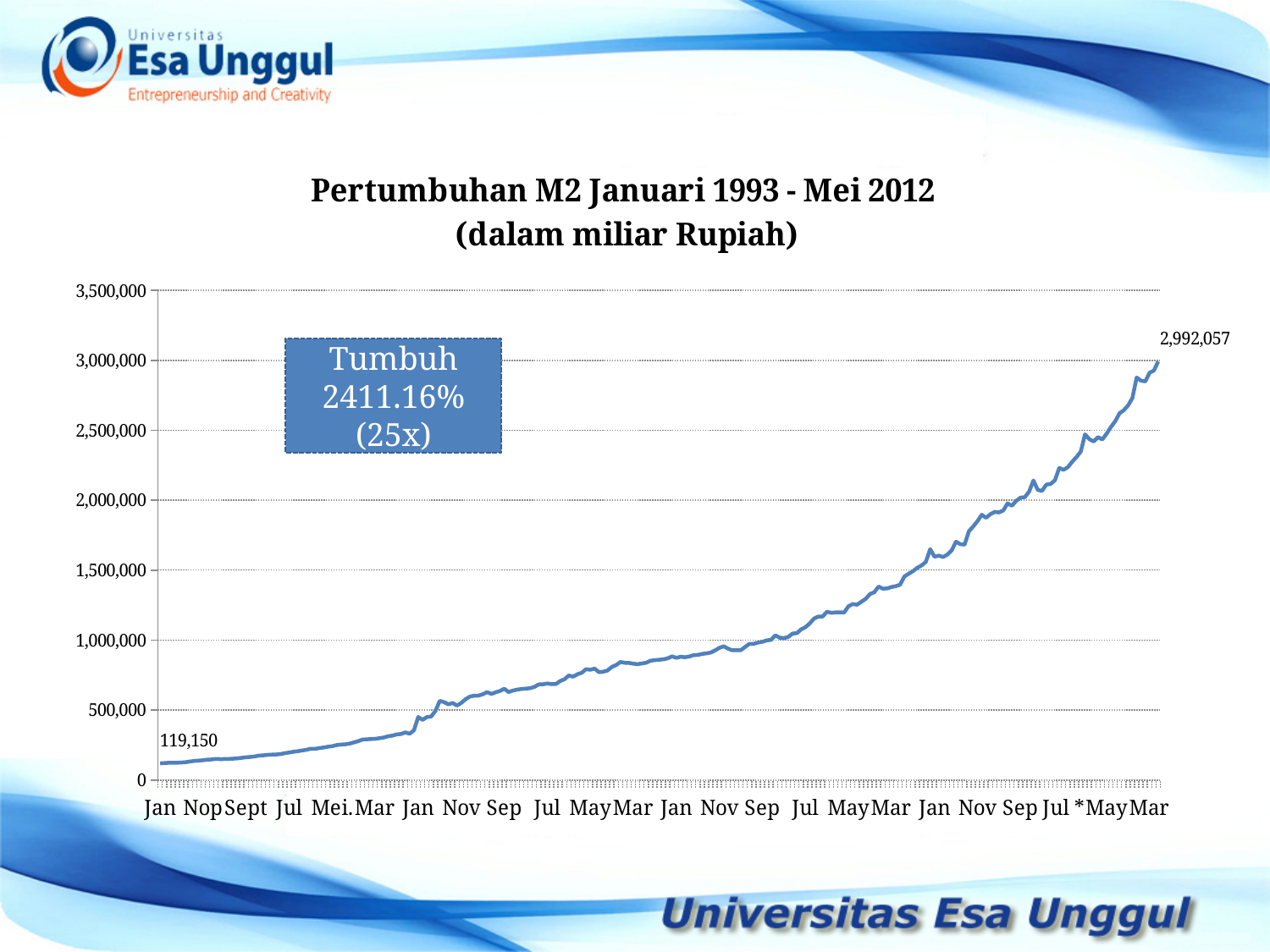
What is the value labelled at the start of the line (January 1993)? 119,150 What kind of chart is shown on the slide? line chart Is the first value of the series greater or less than 500,000? less Which is larger, the value at the start of the series or the value at the end of the series? the value at the end (2,992,057) Do the values generally rise or fall along the x axis from January 1993 to May 2012? rise At which end of the series does the line have its lowest value? the start (January 1993, 119,150) What growth percentage is stated in the text box on the chart? 2411.16% (25x) What is the value labelled at the end of the line (May 2012)? 2,992,057 What is the title of the chart? Pertumbuhan M2 Januari 1993 - Mei 2012 (dalam miliar Rupiah) What is the difference between the final labelled value (2,992,057) and the first labelled value (119,150)? 2,872,907 Is the final value of the series greater or less than 2,500,000? greater At which end of the series does the line reach its highest value? the end (May 2012, 2,992,057)